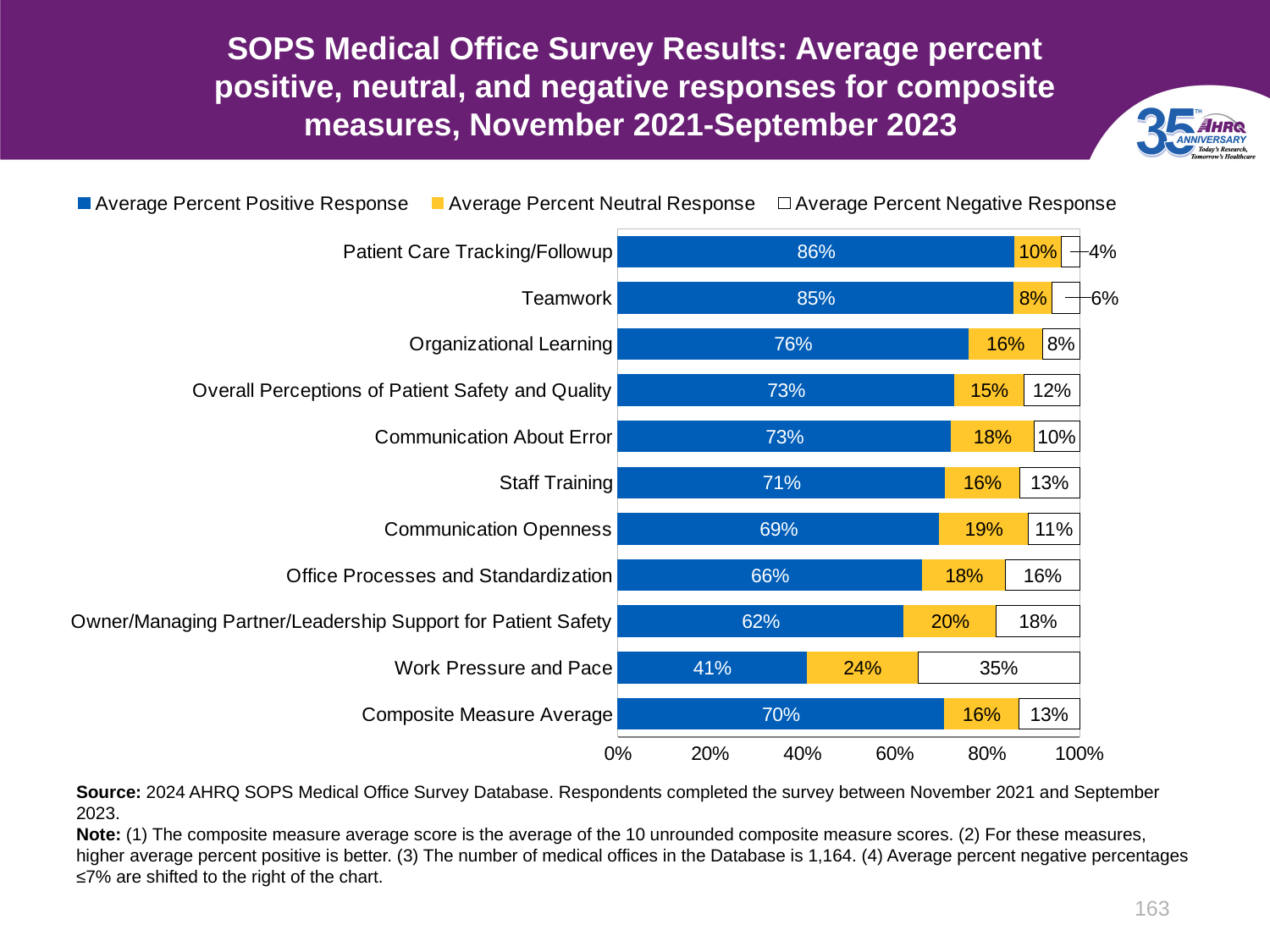
Which composite measure has the highest Average Percent Negative Response? Work Pressure and Pace What is the Average Percent Positive Response for Patient Care Tracking/Followup? 86% How many series does the legend list? 3 What is the difference between the Average Percent Positive Response for Teamwork and for Staff Training? 14% Which has a larger Average Percent Neutral Response, Communication Openness or Organizational Learning? Communication Openness What is the Average Percent Neutral Response for Work Pressure and Pace? 24% What kind of chart is shown on the slide? Stacked bar chart How many composite measure categories are plotted on the chart, including the Composite Measure Average? 11 Which composite measure has the highest Average Percent Positive Response? Patient Care Tracking/Followup Which composite measure has the lowest Average Percent Positive Response? Work Pressure and Pace What is the Average Percent Negative Response for Owner/Managing Partner/Leadership Support for Patient Safety? 18% What is the Average Percent Positive Response for the Composite Measure Average? 70%